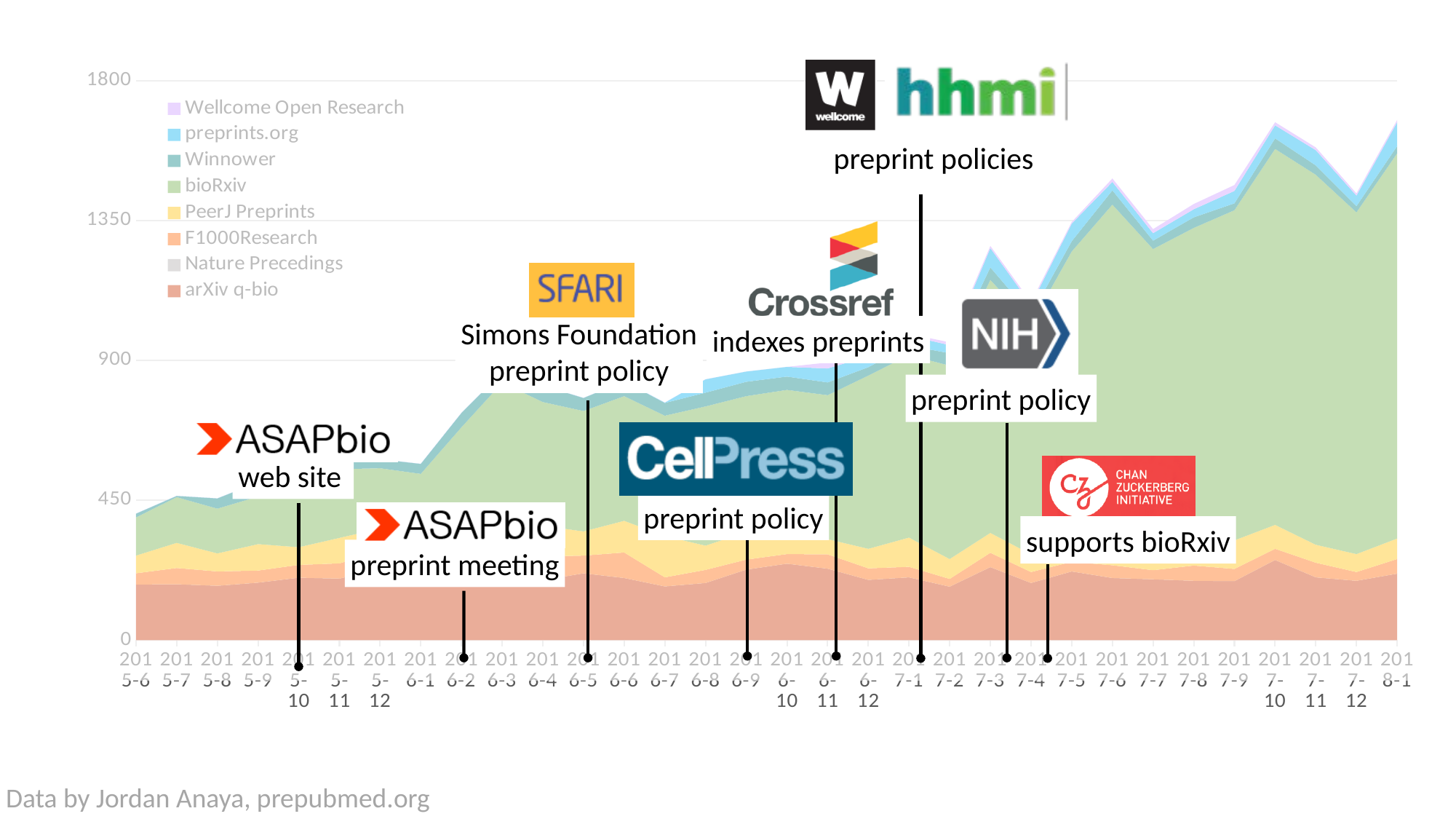
Is the total value for 2016-5 greater or less than 450? greater How many series does the legend list? 8 Which month has the larger total value, 2015-8 or 2016-8? 2016-8 Which month has the larger total value, 2016-6 or 2017-6? 2017-6 How many monthly points are plotted along the x axis? 32 Is the total value for 2017-6 greater or less than 900? greater Is the total value for 2015-6 greater or less than 450? less What kind of chart is shown on the slide? stacked area chart What is the first month shown on the x axis? 2015-6 Which series is shown in green in the legend? bioRxiv Overall, do the total values rise or fall from 2015-6 to 2018-1? rise